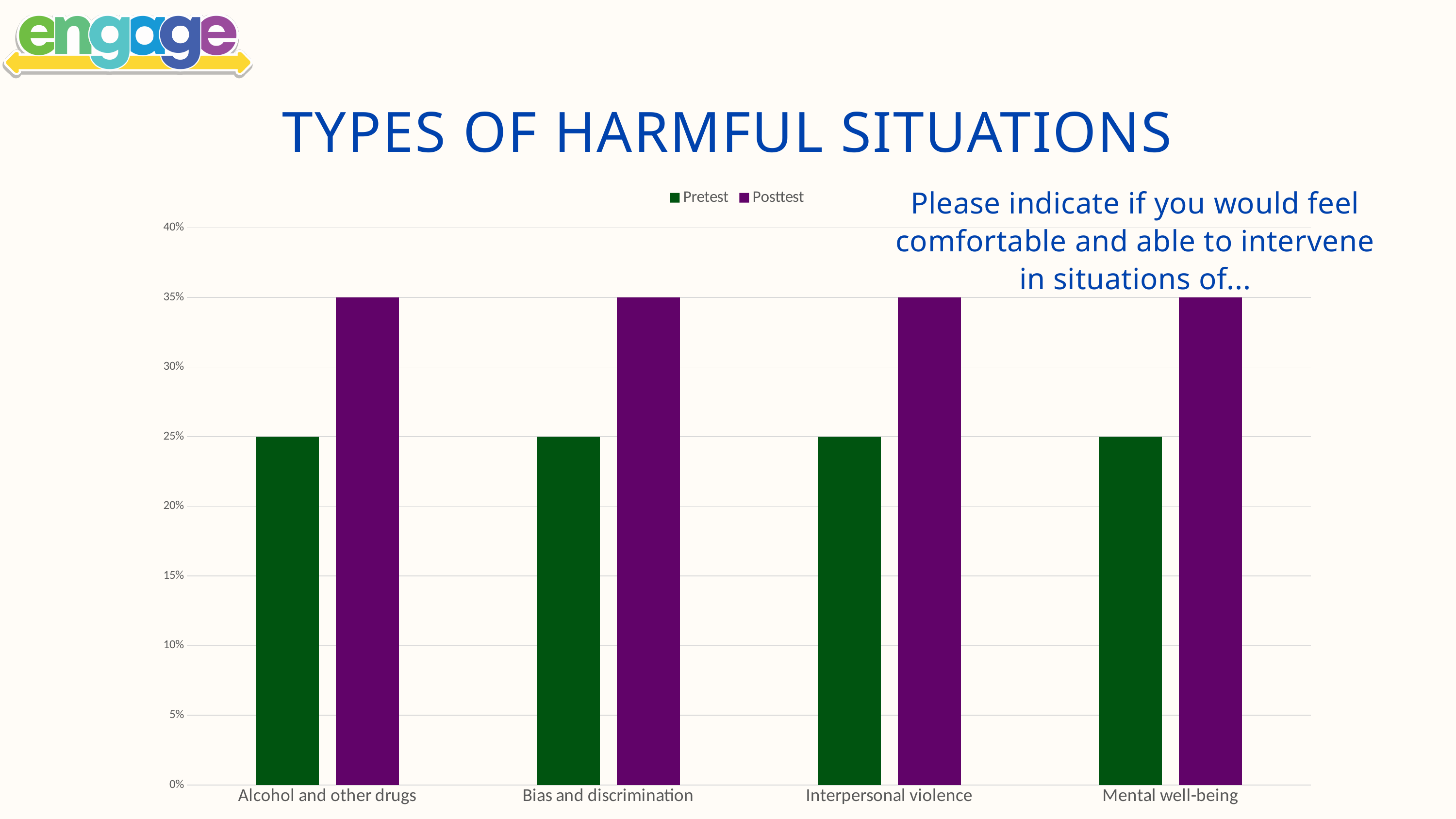
What is the Pretest value for Interpersonal violence? 25% Which is larger for Interpersonal violence, the Pretest or the Posttest value? Posttest What is the title of the chart? TYPES OF HARMFUL SITUATIONS What is the difference between the Posttest and Pretest values for Mental well-being? 10% What is the Posttest value for Mental well-being? 35% How many categories are shown on the x axis? 4 What is the Pretest value for Alcohol and other drugs? 25% Which series is shown in purple? Posttest How many series does the legend list? 2 What is the Posttest value for Bias and discrimination? 35% Is the Posttest value for Alcohol and other drugs greater or less than 30%? greater What kind of chart is shown on the slide? Bar chart